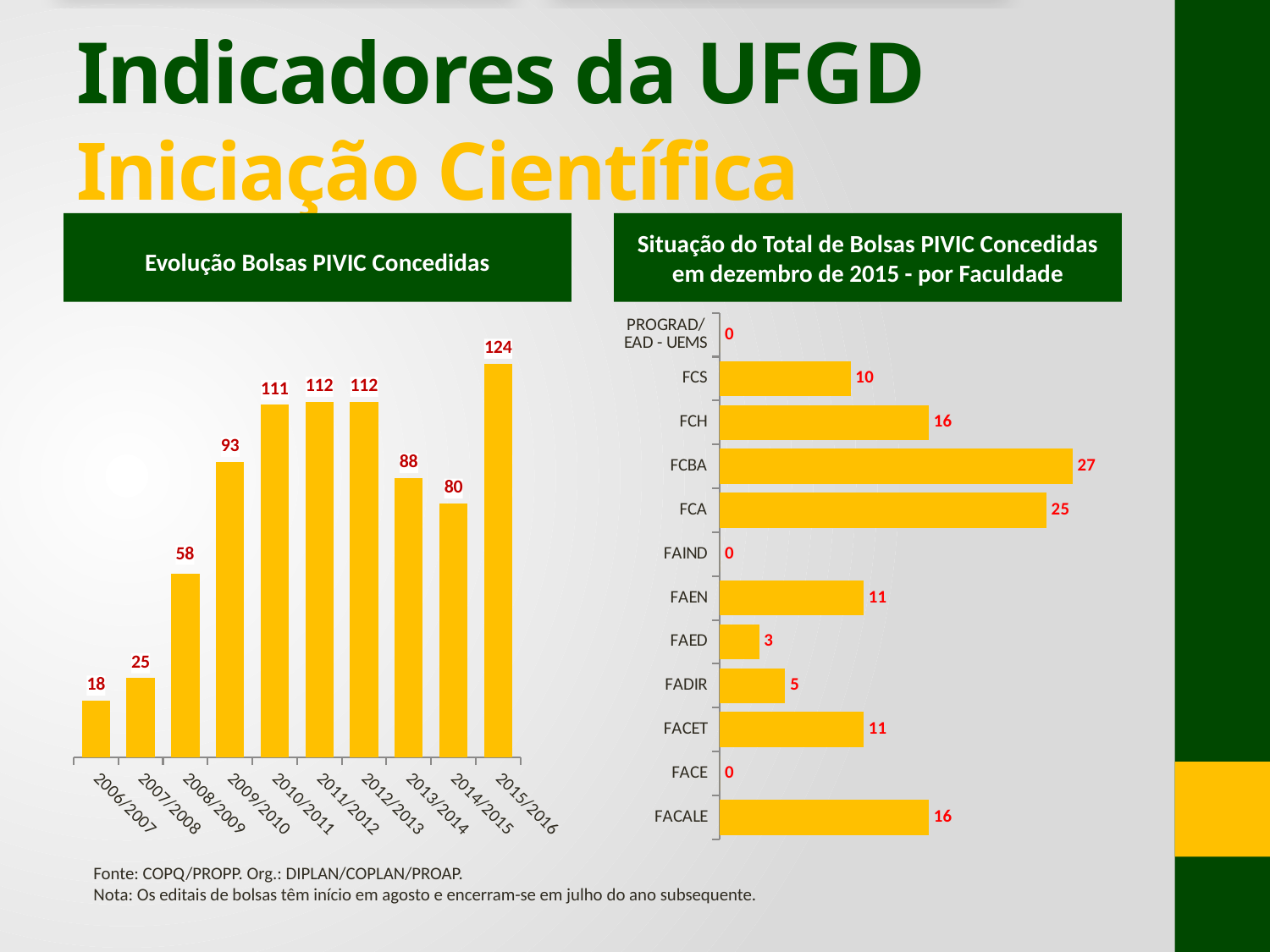
In the 'Evolução Bolsas PIVIC Concedidas' chart, which year has the highest value? 2015/2016 In the 'Evolução Bolsas PIVIC Concedidas' chart, which is larger, the value for 2012/2013 or the value for 2013/2014? 2012/2013 In the 'Evolução Bolsas PIVIC Concedidas' chart, how many years are shown on the x axis? 10 In the 'Situação do Total de Bolsas PIVIC Concedidas em dezembro de 2015 - por Faculdade' chart, what is the difference between the values for FCBA and FCH? 11 In the 'Situação do Total de Bolsas PIVIC Concedidas em dezembro de 2015 - por Faculdade' chart, what is the value for FCA? 25 In the 'Evolução Bolsas PIVIC Concedidas' chart, what is the difference between the values for 2015/2016 and 2014/2015? 44 In the 'Situação do Total de Bolsas PIVIC Concedidas em dezembro de 2015 - por Faculdade' chart, how many faculties are listed? 12 In the 'Situação do Total de Bolsas PIVIC Concedidas em dezembro de 2015 - por Faculdade' chart, which is larger, the value for FAED or the value for FADIR? FADIR In the 'Evolução Bolsas PIVIC Concedidas' chart, which year has the lowest value? 2006/2007 What kind of chart is the 'Situação do Total de Bolsas PIVIC Concedidas em dezembro de 2015 - por Faculdade' chart? Bar chart In the 'Situação do Total de Bolsas PIVIC Concedidas em dezembro de 2015 - por Faculdade' chart, which faculty has the highest value? FCBA In the 'Evolução Bolsas PIVIC Concedidas' chart, what is the value for 2008/2009? 58